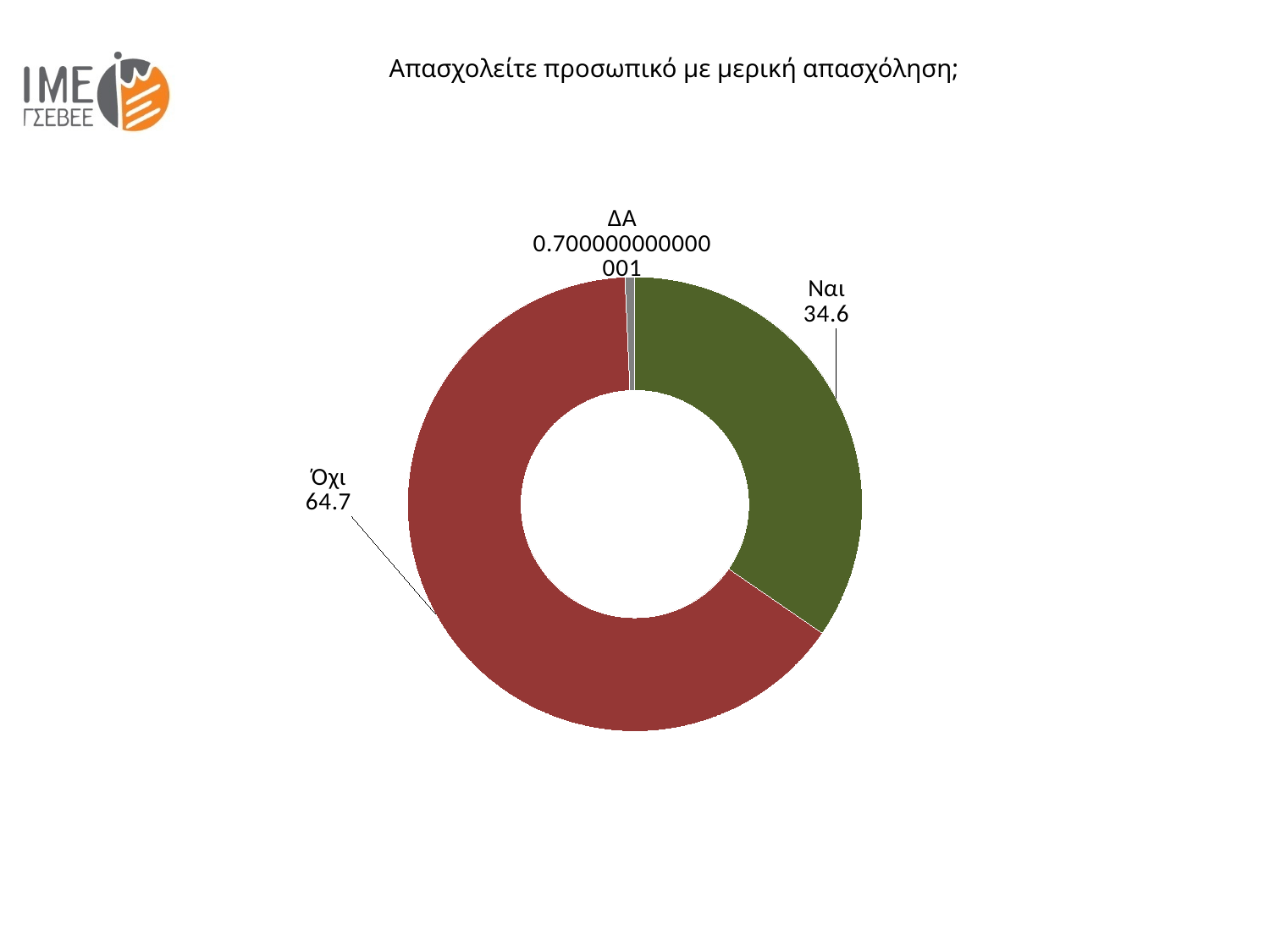
What is the title of the chart? Απασχολείτε προσωπικό με μερική απασχόληση; How many categories are shown in the chart? 3 What value is shown for ΔΑ? 0.700000000000001 Which category has the largest slice? Όχι What is the value for Όχι? 64.7 What is the difference between the values for Όχι and Ναι? 30.1 Which is larger, the value for Ναι or the value for Όχι? Όχι What is the value for Ναι? 34.6 What kind of chart is shown on the slide? doughnut chart Which category has the smallest slice? ΔΑ What colour is the slice for Ναι? green